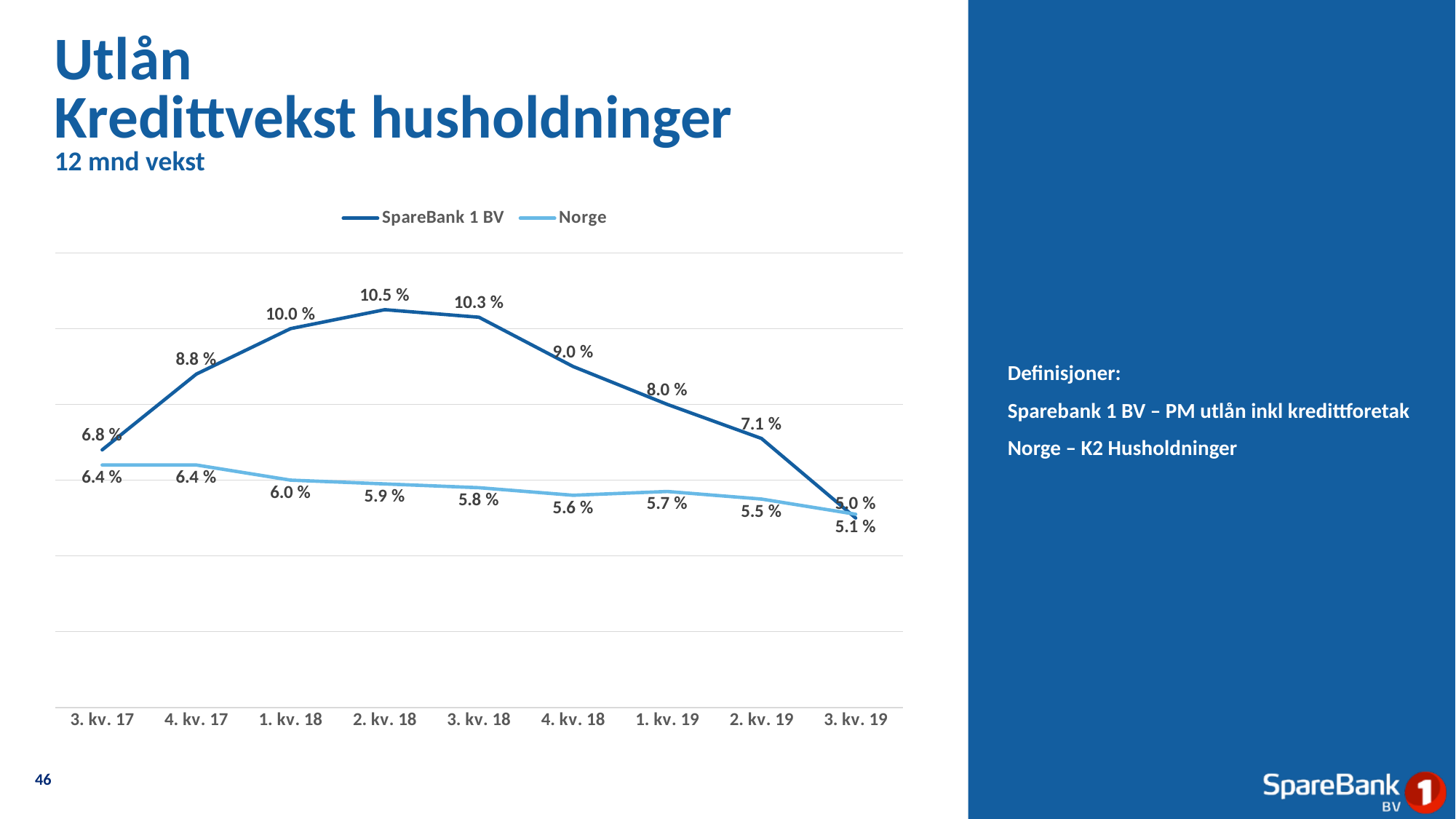
In which quarter does Norge have its lowest value? 3. kv. 19 What is the value for SpareBank 1 BV in 2. kv. 18? 10.5 % What kind of chart is shown on the slide? line chart What is the value for Norge in 4. kv. 18? 5.6 % How many quarters are plotted along the x axis? 9 What is the value for SpareBank 1 BV in 3. kv. 19? 5.0 % What is the subtitle shown under the chart title? 12 mnd vekst How many series does the legend list? 2 Does the Norge series rise or fall from 3. kv. 17 to 3. kv. 19? fall What is the difference between SpareBank 1 BV and Norge in 3. kv. 18? 4.5 % In which quarter does SpareBank 1 BV reach its highest value? 2. kv. 18 Which series has the higher value in 2. kv. 19, SpareBank 1 BV or Norge? SpareBank 1 BV